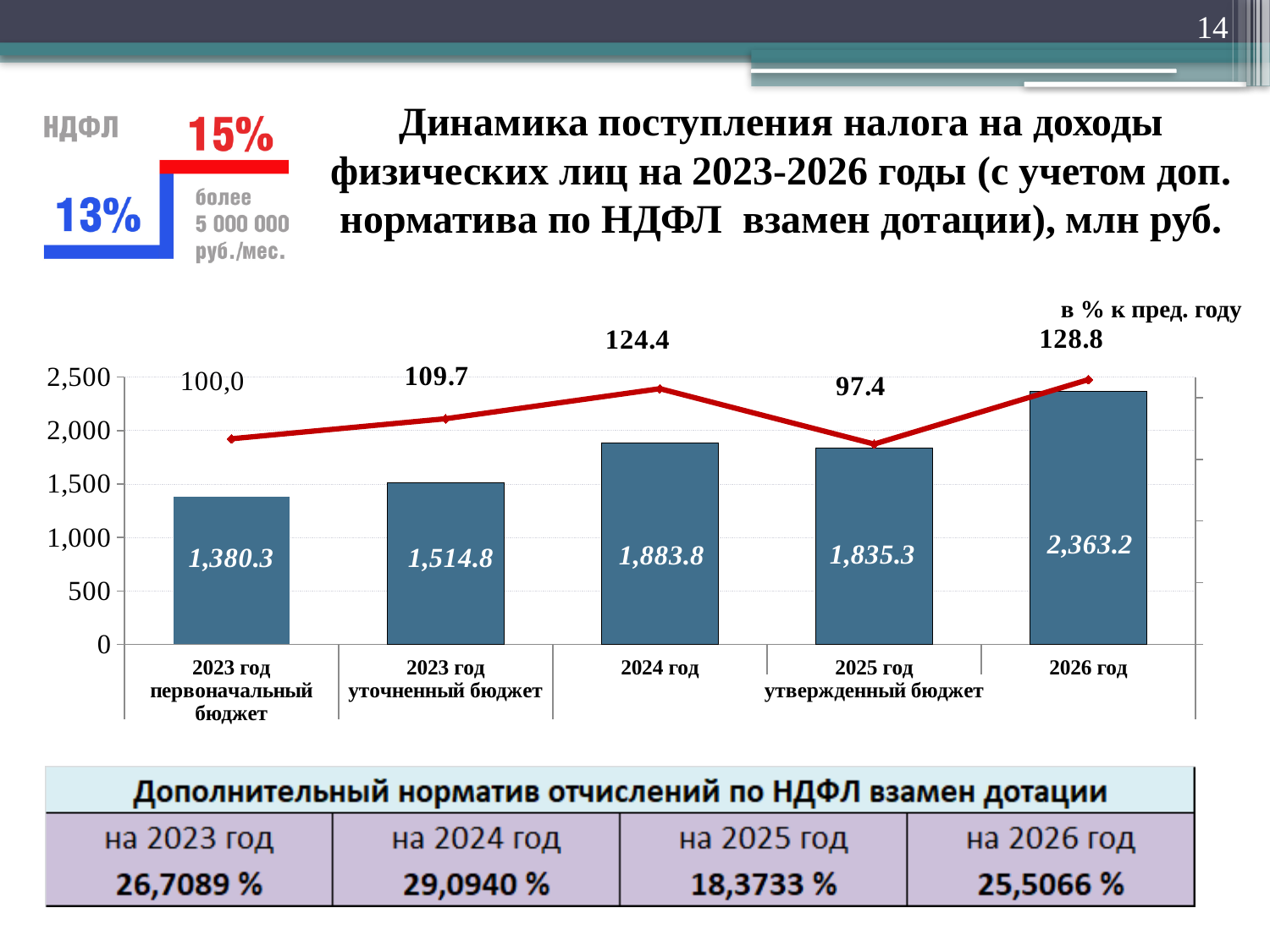
Which category has the highest bar value? 2026 год What kind of chart is this? Bar chart with a line What is the difference between the values for 2026 год and 2025 год? 527.9 How many categories are shown on the x axis? 5 What is the value for 2023 год уточненный бюджет? 1,514.8 What is the value for 2026 год? 2,363.2 Which category has the lowest bar value? 2023 год первоначальный бюджет Which is larger, the value for 2024 год or the value for 2025 год? 2024 год What is the percentage to the previous year (в % к пред. году) shown for 2024 год? 124.4 What is the difference between the values for 2024 год and 2025 год? 48.5 What is the percentage to the previous year (в % к пред. году) shown for 2025 год? 97.4 What is the value for 2024 год? 1,883.8